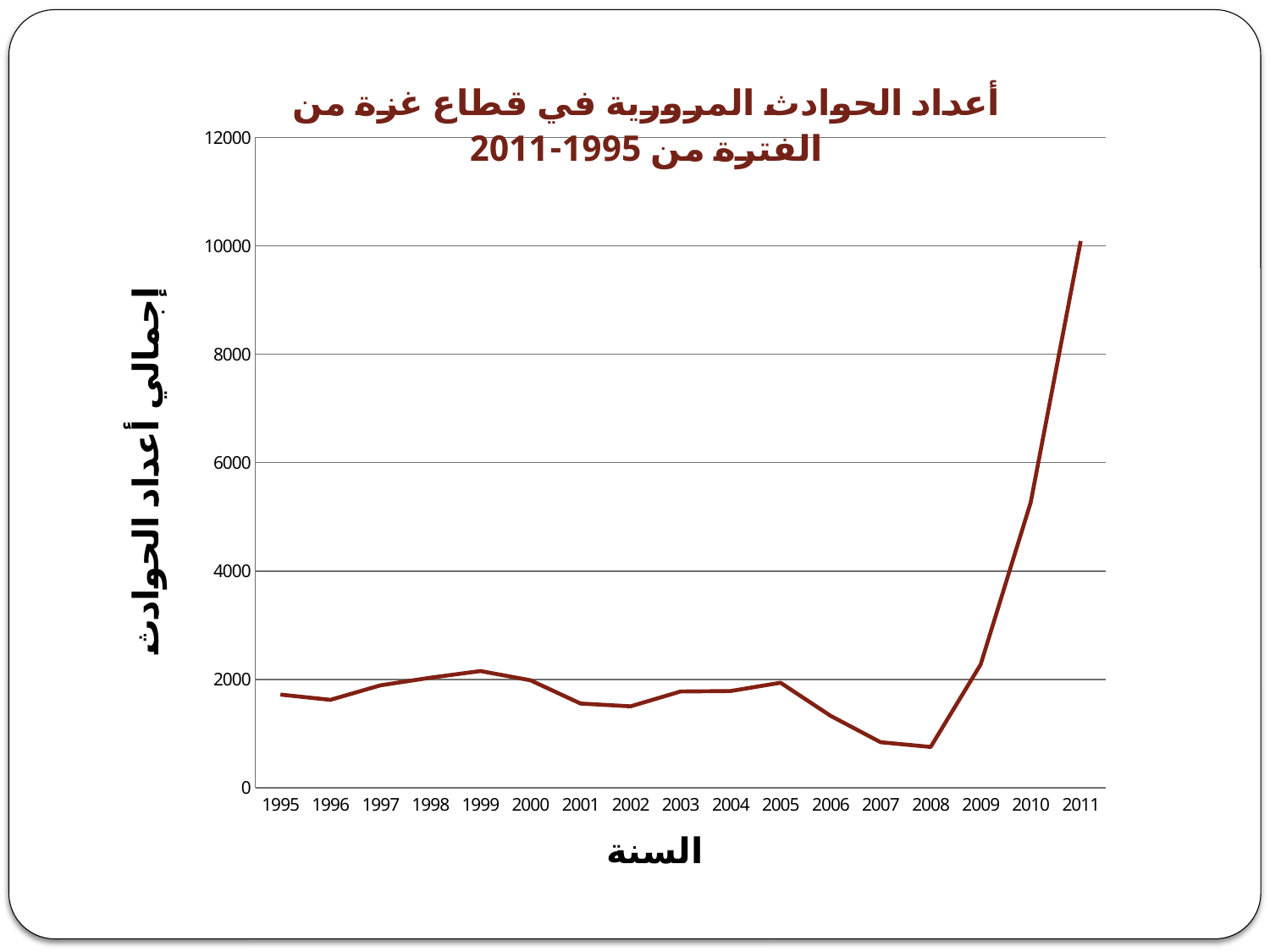
Is the value for 2008 greater or less than 2000? less How many years are plotted along the x axis? 17 Which year has the highest number of accidents? 2011 Is the value for 2011 greater or less than 8000? greater Which year has a larger value, 1995 or 2008? 1995 Is the value for 2010 greater or less than 4000? greater What is the label of the x axis? السنة Do the values rise or fall from 2008 to 2011? rise Which year has a larger value, 2010 or 2011? 2011 Which year has the lowest number of accidents? 2008 What kind of chart is shown on the slide? line chart